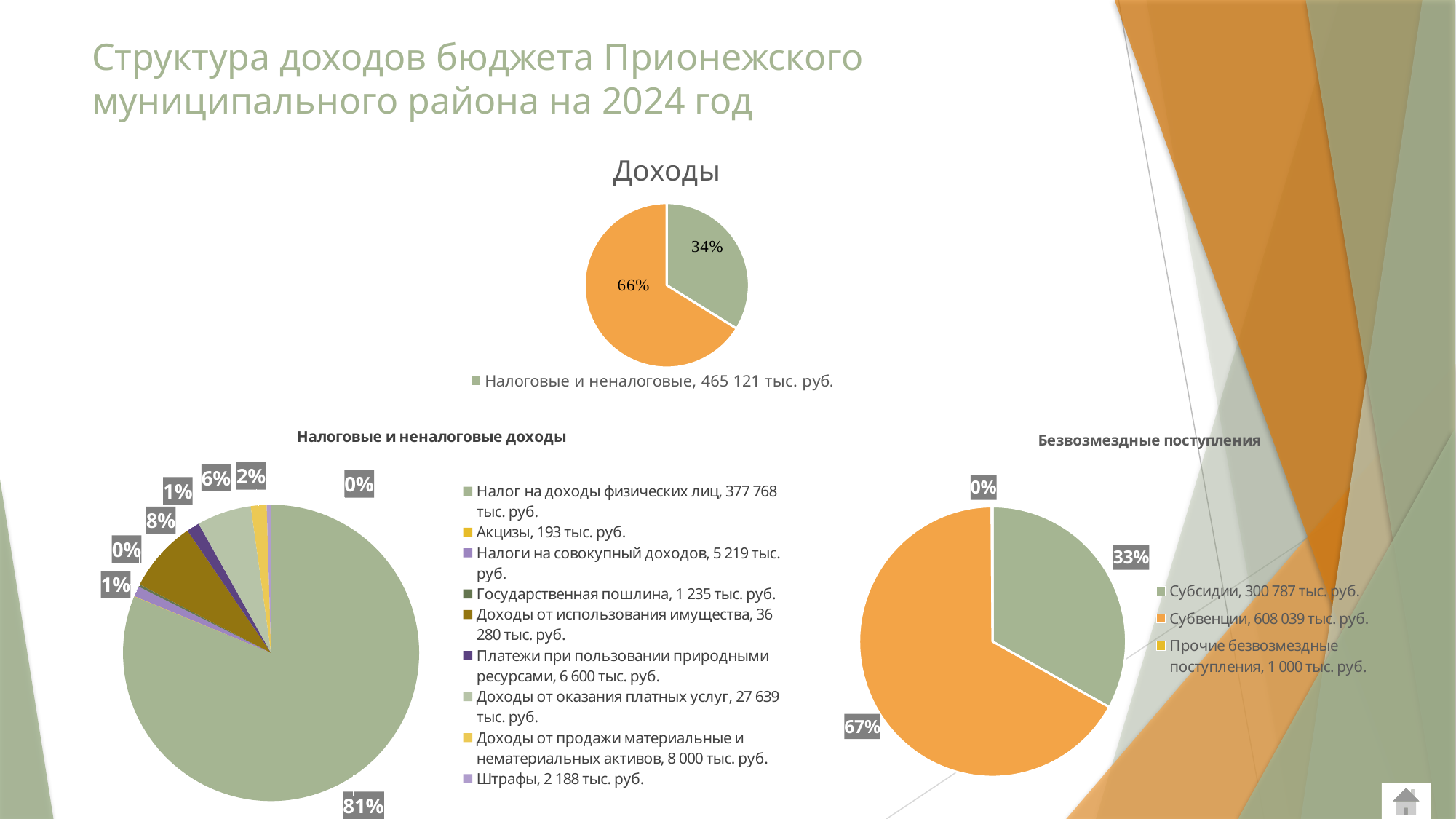
How many entries does the legend of the "Налоговые и неналоговые доходы" chart list? 9 In the "Безвозмездные поступления" chart, what share of the pie is "Субвенции"? 67% What kind of chart is the "Доходы" chart? pie chart In the "Налоговые и неналоговые доходы" chart, which is larger: "Доходы от использования имущества" or "Доходы от оказания платных услуг"? Доходы от использования имущества In the "Доходы" chart, what share of the pie is "Налоговые и неналоговые"? 34% In the "Безвозмездные поступления" chart, what is the value for "Субвенции"? 608 039 тыс. руб. In the "Безвозмездные поступления" chart, what share of the pie is "Субсидии"? 33% In the "Безвозмездные поступления" chart, which category is the smallest? Прочие безвозмездные поступления In the "Безвозмездные поступления" chart, what is the difference between "Субвенции" and "Субсидии"? 307 252 тыс. руб. How many entries does the legend of the "Безвозмездные поступления" chart list? 3 In the "Безвозмездные поступления" chart, which category is the largest? Субвенции